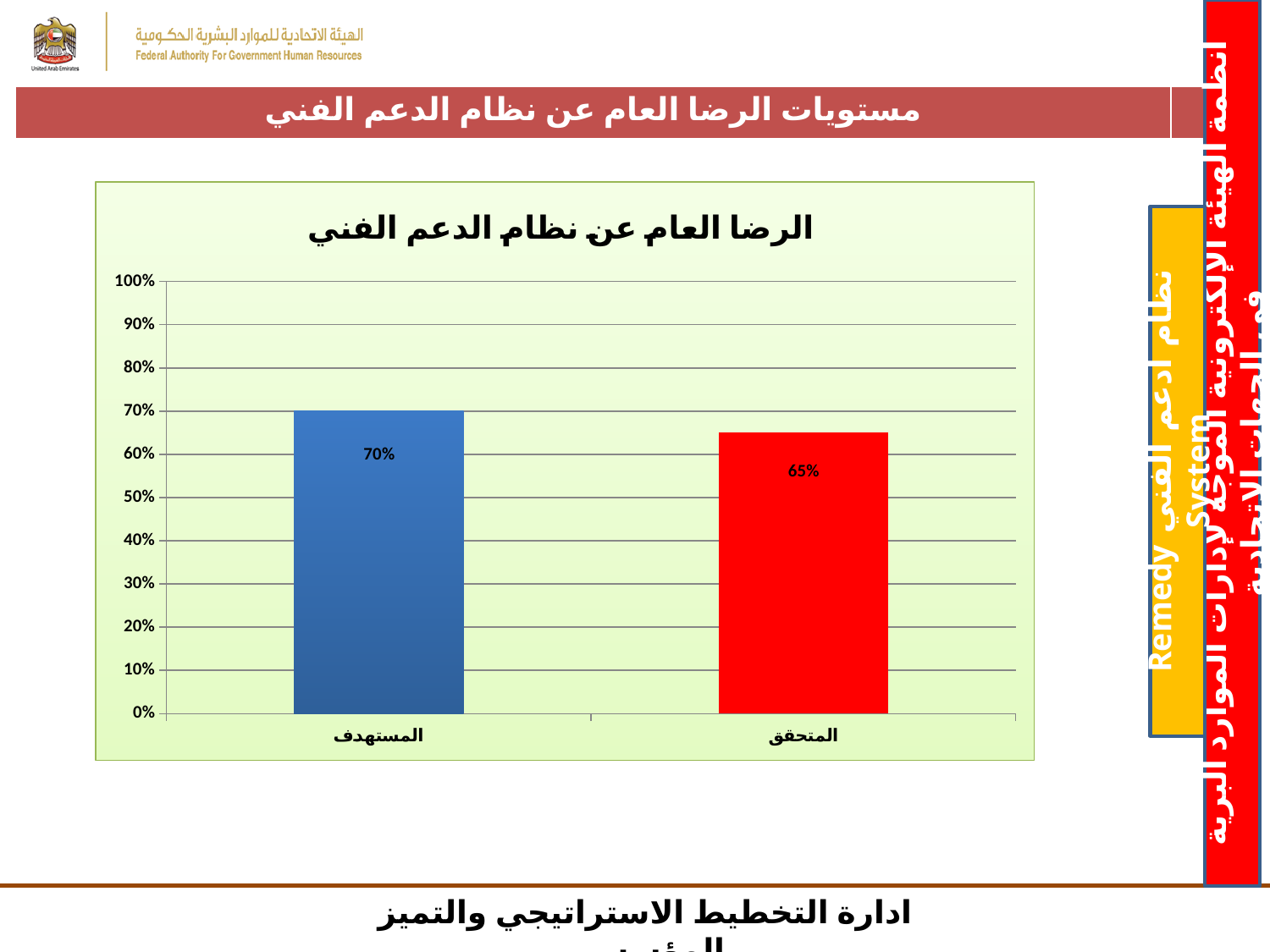
Which is larger, the value for المستهدف or the value for المتحقق? المستهدف Is the value for المتحقق greater or less than 60%? greater Which category has the lowest value? المتحقق How many categories are shown on the x axis? 2 What is the title of the chart? الرضا العام عن نظام الدعم الفني What is the value for المتحقق? 65% Which category has the highest value? المستهدف What is the value for المستهدف? 70% What is the difference between the values for المستهدف and المتحقق? 5% What colour is the bar for المتحقق? red What kind of chart is shown? bar chart Is the value for المستهدف greater or less than 80%? less